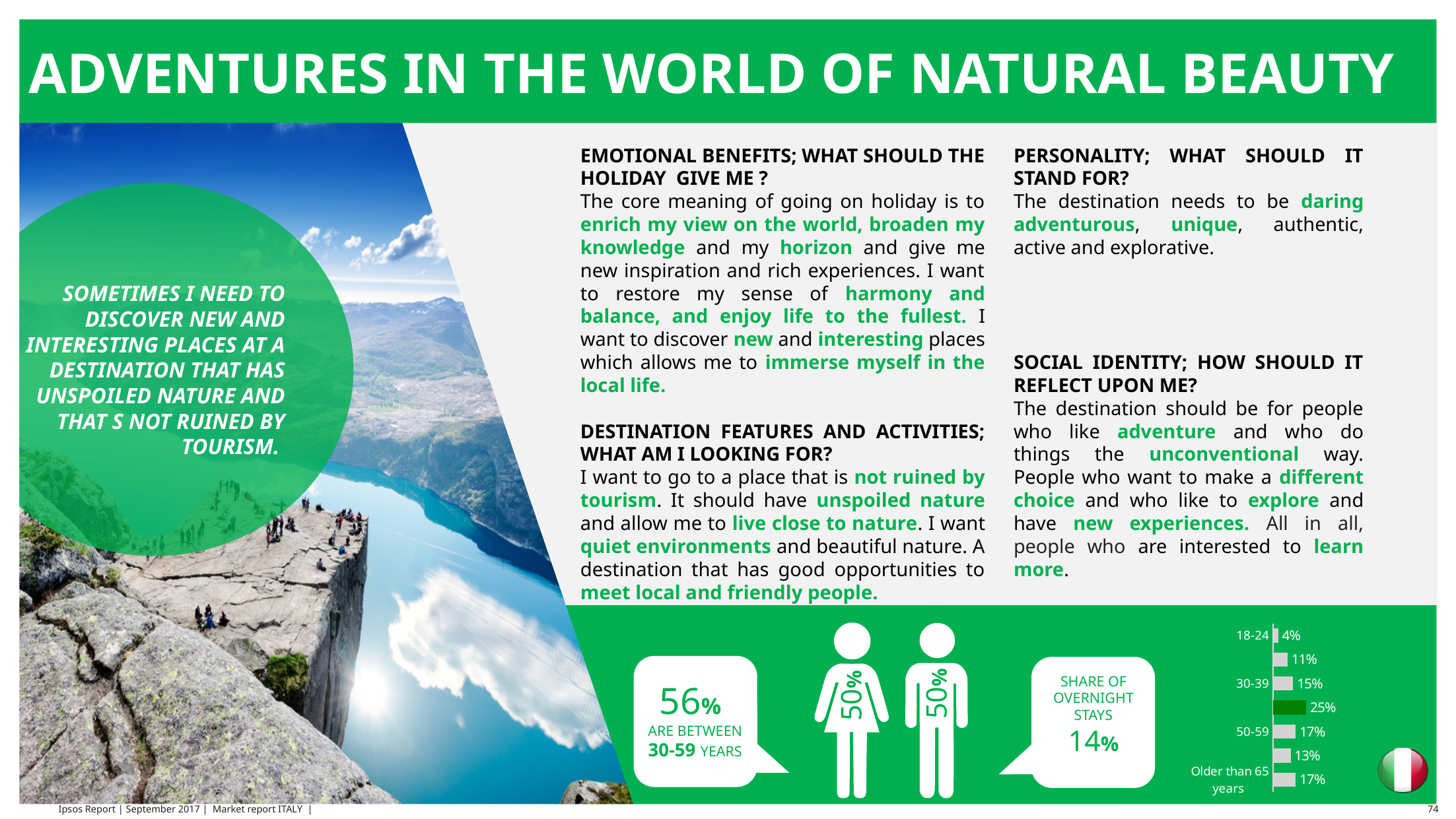
What is the highest value shown in the age-group bar chart? 25% What is the difference between the values for the 30-39 and 18-24 age groups? 11% What is the value for the 'Older than 65 years' group in the bar chart? 17% What is the difference between the values for the 50-59 and 30-39 age groups? 2% What is the value for the 50-59 age group in the bar chart? 17% Which is larger in the bar chart: the value for 30-39 or the value for 50-59? 50-59 Which bar in the age-group chart is coloured dark green rather than grey? The 25% bar What kind of chart is used to show the age-group breakdown? Bar chart Which labelled age group has the lowest value in the bar chart? 18-24 What is the value for the 30-39 age group in the bar chart? 15% What is the value for the 18-24 age group in the bar chart? 4% How many bars are shown in the age-group chart? 7